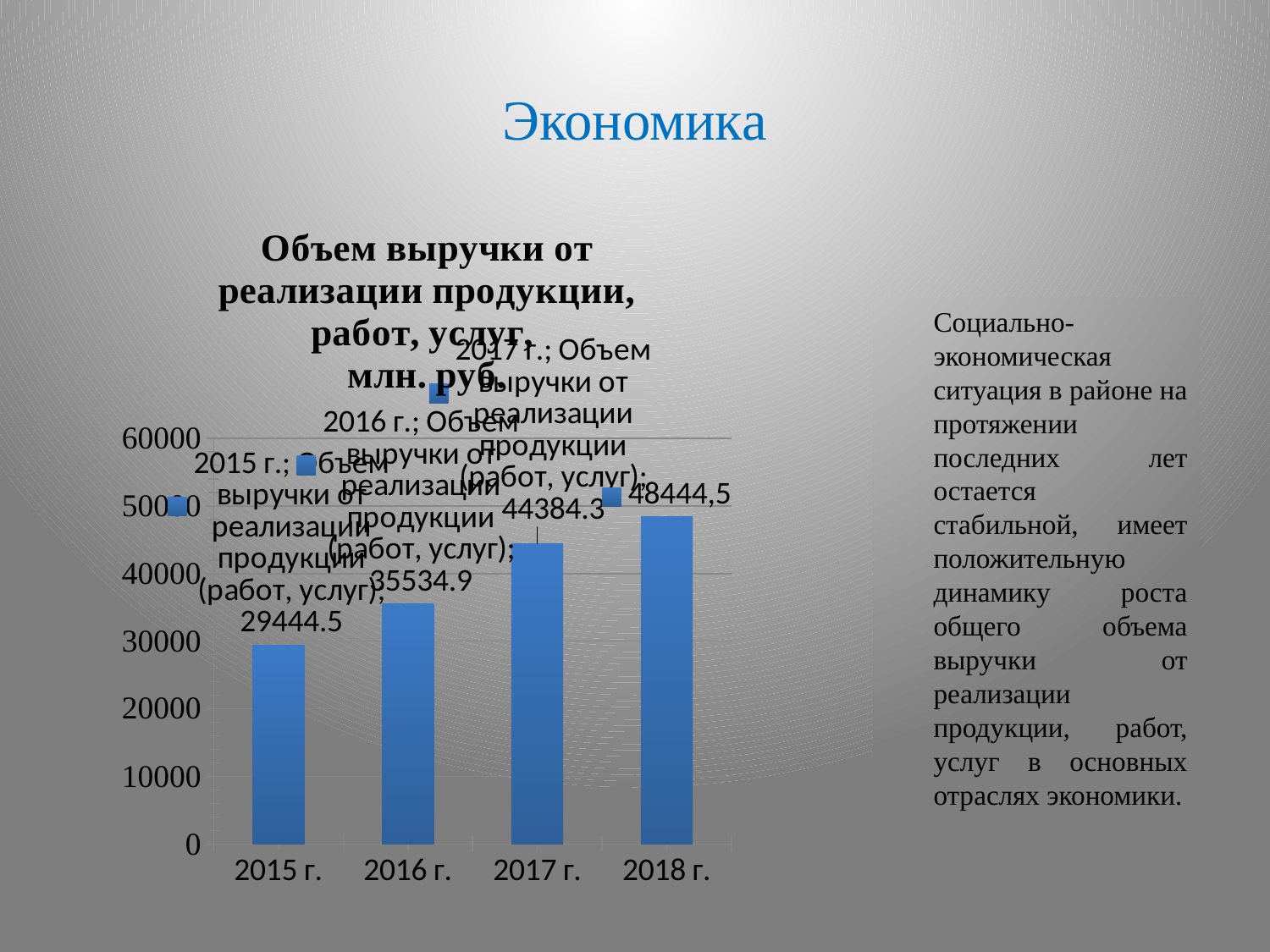
Which is larger, the value for 2017 г. or the value for 2016 г.? 2017 г. What is the difference between the values for 2016 г. and 2015 г.? 6090.4 What is the difference between the values for 2017 г. and 2016 г.? 8849.4 Which year has the highest value in the chart? 2018 г. How many years (categories) are shown on the x axis of the chart? 4 What is the value for 2017 г. in the chart? 44384.3 What is the value for 2015 г. in the chart? 29444.5 Is the value for 2018 г. greater or less than 40000? greater What is the value for 2018 г. in the chart? 48444,5 Which year has the lowest value in the chart? 2015 г. What type of chart is shown on the slide? bar chart What is the value for 2016 г. in the chart? 35534.9